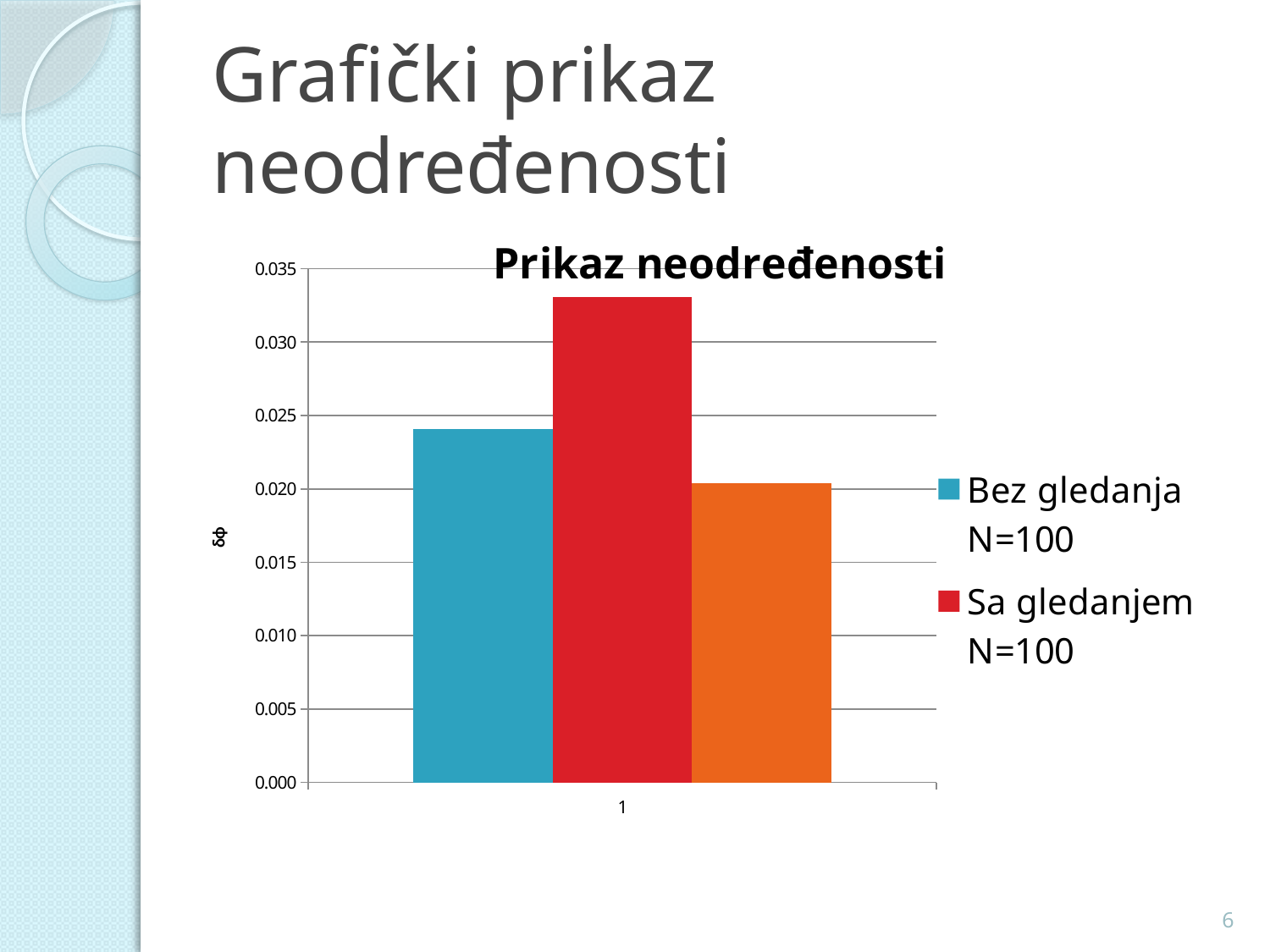
What is the title of the chart? Prikaz neodređenosti Is the value for Bez gledanja N=100 greater or less than 0.020? greater Is the value for Sa gledanjem N=100 greater or less than 0.030? greater Which is larger, the value for Bez gledanja N=100 or the value for Sa gledanjem N=100? Sa gledanjem N=100 Which series has the highest bar in the chart? Sa gledanjem N=100 How many bars are plotted in the chart? 3 What colour is the bar for Sa gledanjem N=100? red How many series does the chart legend list? 2 What is the label on the vertical axis of the chart? δφ What kind of chart is shown on the slide? bar chart Is the value for Bez gledanja N=100 greater or less than 0.025? less